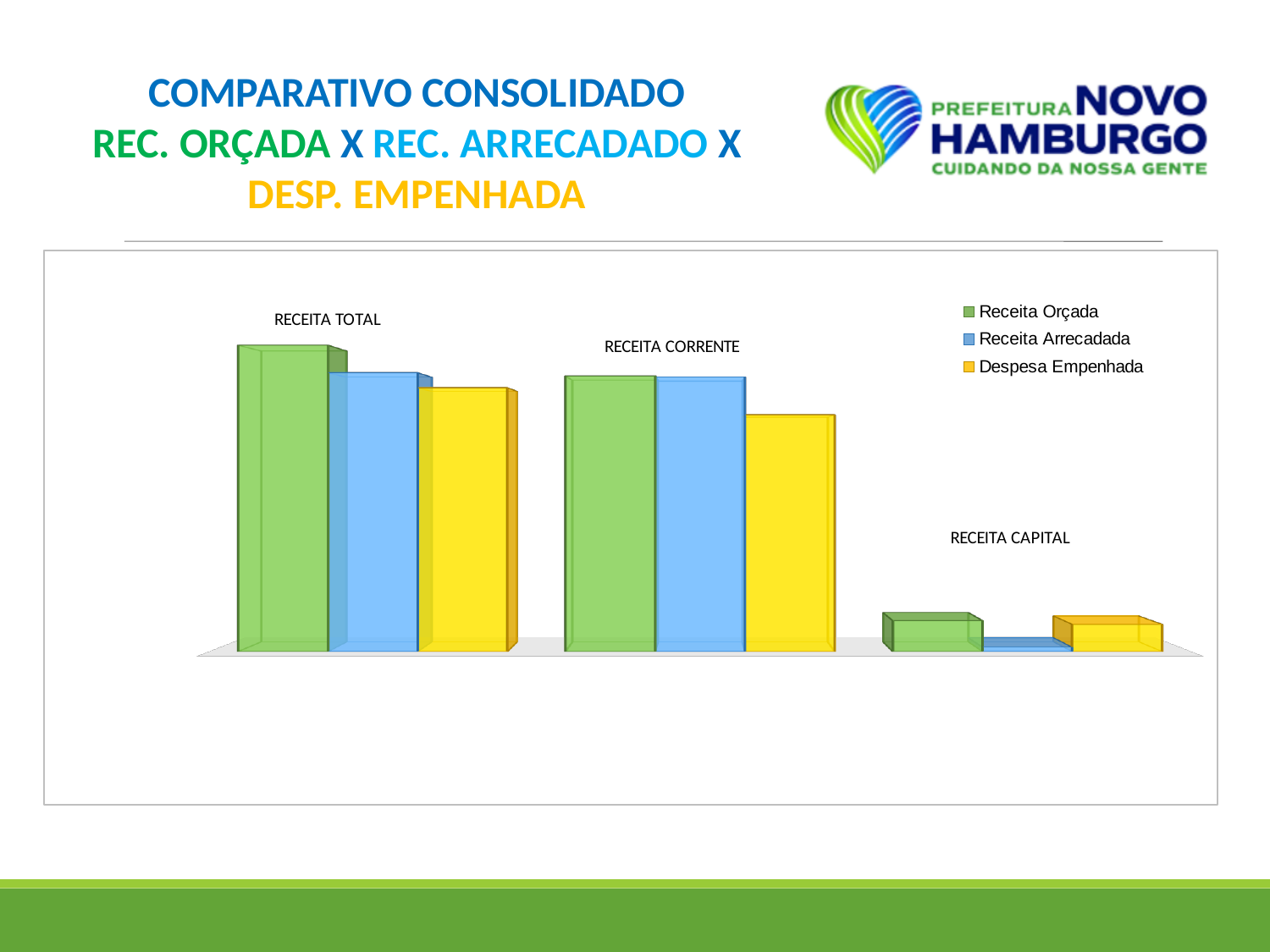
For RECEITA TOTAL, which is larger: Receita Orçada or Despesa Empenhada? Receita Orçada What colour represents Despesa Empenhada in the chart? Yellow What kind of chart is shown on the slide? Bar chart Within the RECEITA CAPITAL category, which series has the lowest bar? Receita Arrecadada Which category has the lowest Receita Arrecadada bar? RECEITA CAPITAL How many categories are plotted on the chart? 3 Is the Receita Orçada bar larger for RECEITA CORRENTE or for RECEITA CAPITAL? RECEITA CORRENTE How many series does the chart legend list? 3 What are the three series listed in the chart legend? Receita Orçada, Receita Arrecadada, Despesa Empenhada Within the RECEITA TOTAL category, which series has the highest bar? Receita Orçada Which category has the highest Receita Orçada bar? RECEITA TOTAL For RECEITA CORRENTE, which is larger: Receita Arrecadada or Despesa Empenhada? Receita Arrecadada